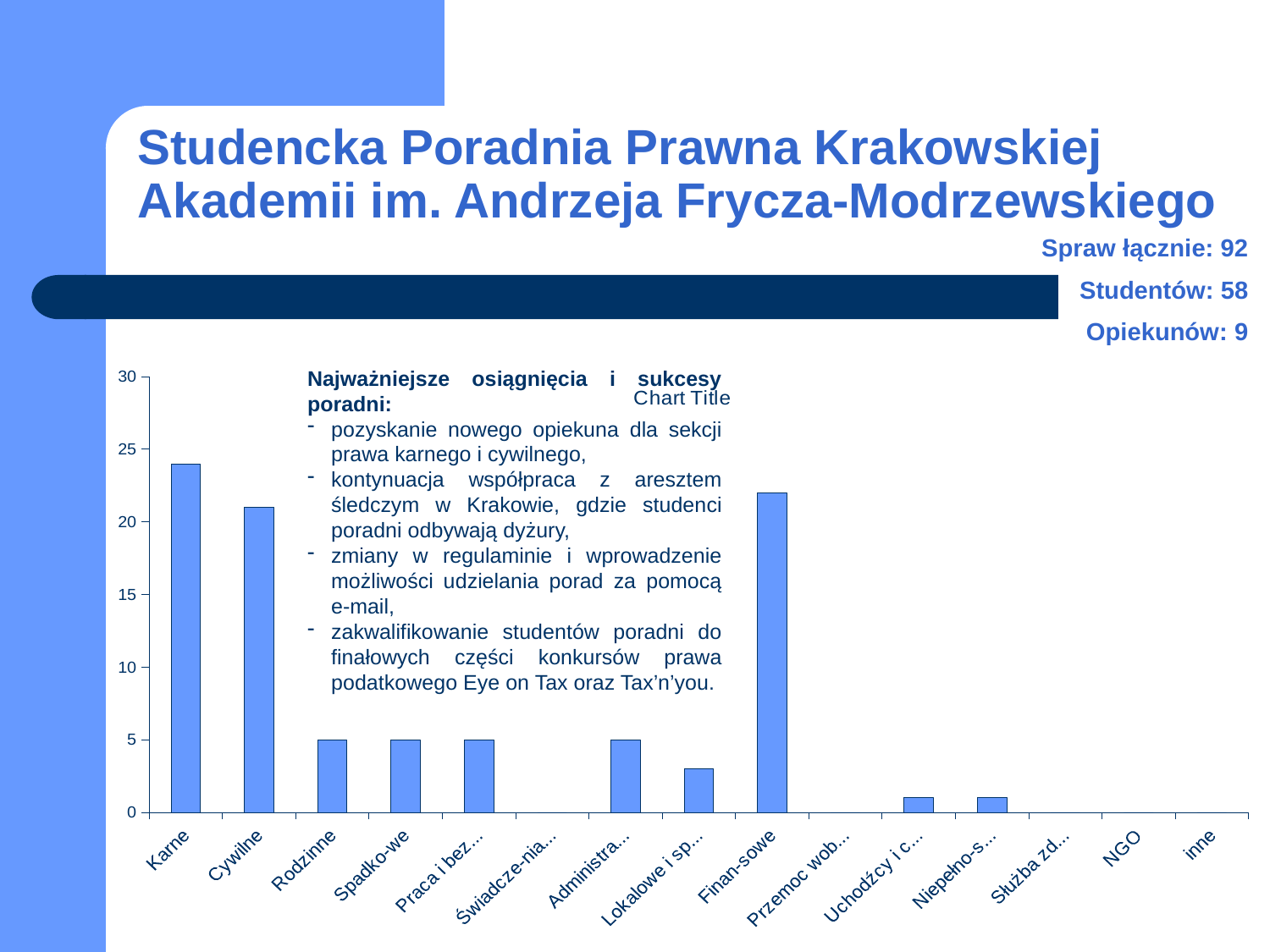
How many categories are shown on the x axis of the chart? 15 Is the value for Lokalowe i sp... greater or less than 5? less Is the value for Karne greater or less than 20? greater Which is larger, the value for Karne or the value for Cywilne? Karne What is the value for Spadko-we? 5 What is the value for Administra...? 5 What kind of chart is shown on the slide? bar chart What is the value for Rodzinne? 5 What is the title shown on the chart? Chart Title Is the value for Finan-sowe greater or less than 20? greater Which category has the highest value in the chart? Karne